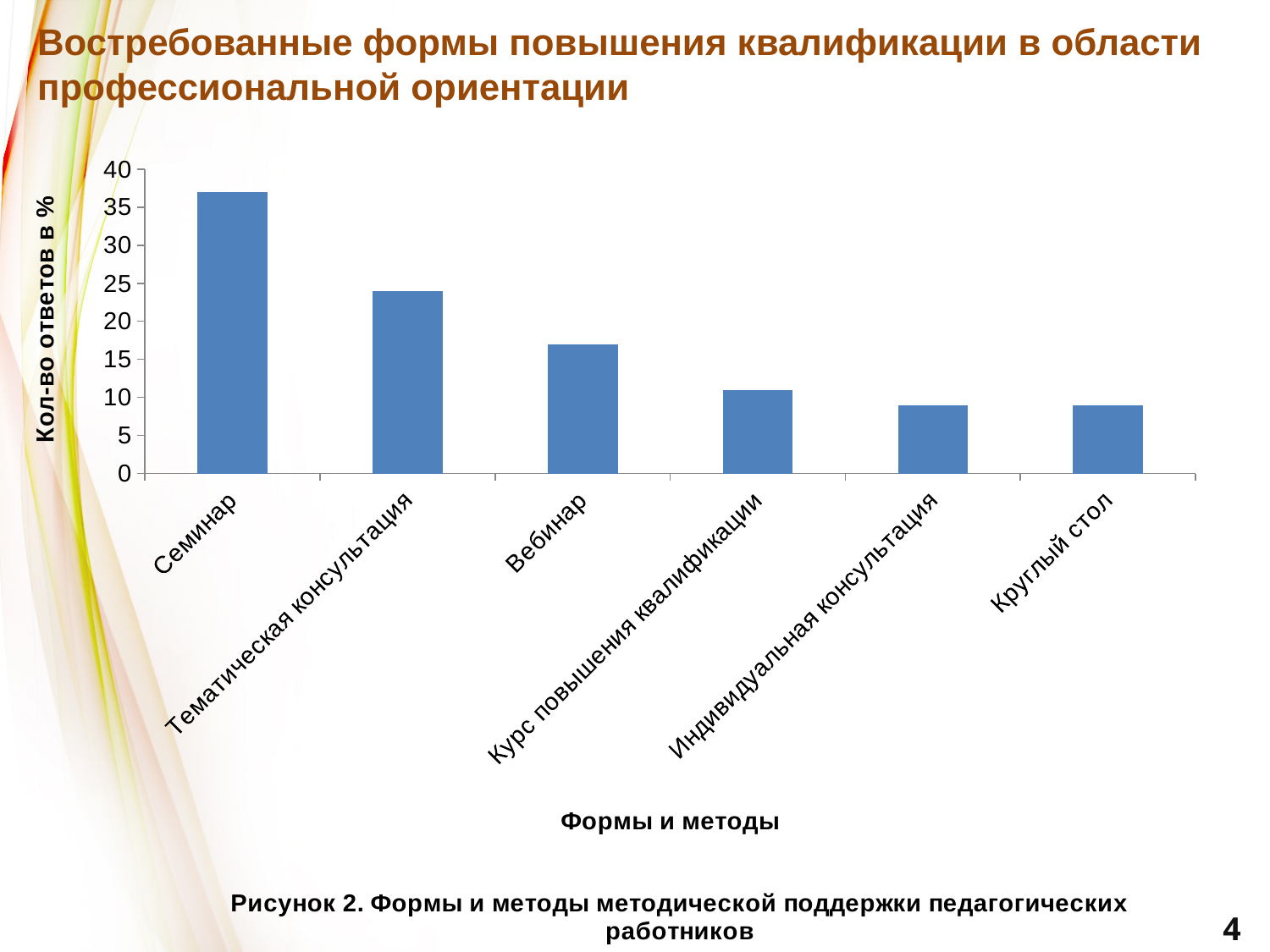
Is the value for Семинар greater or less than 35? greater What is the title of the vertical axis of the chart? Кол-во ответов в % Do the values rise or fall moving from left to right along the x axis? fall How many categories are plotted on the x axis of the chart? 6 What kind of chart is shown on the slide? bar chart Which category has the highest value in the chart? Семинар Is the value for Тематическая консультация greater or less than 20? greater Which is larger, the value for Семинар or the value for Вебинар? Семинар Which is larger, the value for Тематическая консультация or the value for Индивидуальная консультация? Тематическая консультация Is the value for Вебинар greater or less than 20? less